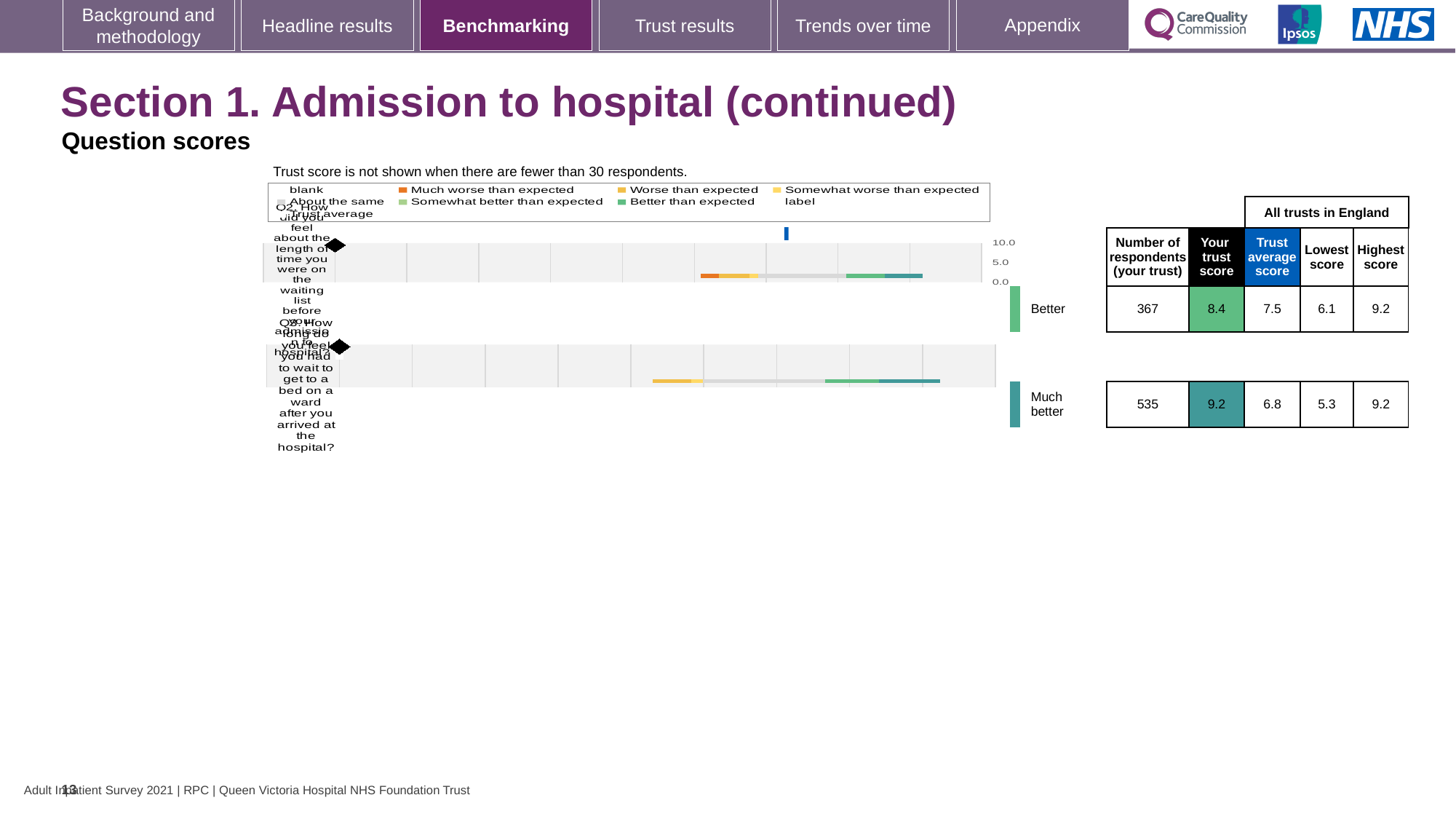
How many respondents answered Q3 at this trust? 535 What is the trust average score across all trusts in England for Q2? 7.5 What benchmark rating label is shown next to Q3? Much better What is the trust score for Q2 (how did you feel about the length of time on the waiting list)? 8.4 What is the trust score for Q3 (how long did you feel you had to wait to get to a bed on a ward)? 9.2 By how much does the trust score for Q2 exceed the trust average score for Q2? 0.9 What kind of chart is used to show the question scores on this slide? bar chart Which question has the higher trust score, Q2 or Q3? Q3 What is the difference between the highest score and the lowest score for Q3 across all trusts in England? 3.9 How many questions are plotted in the chart? 2 What benchmark rating label is shown next to Q2? Better What is the lowest score among all trusts in England for Q3? 5.3